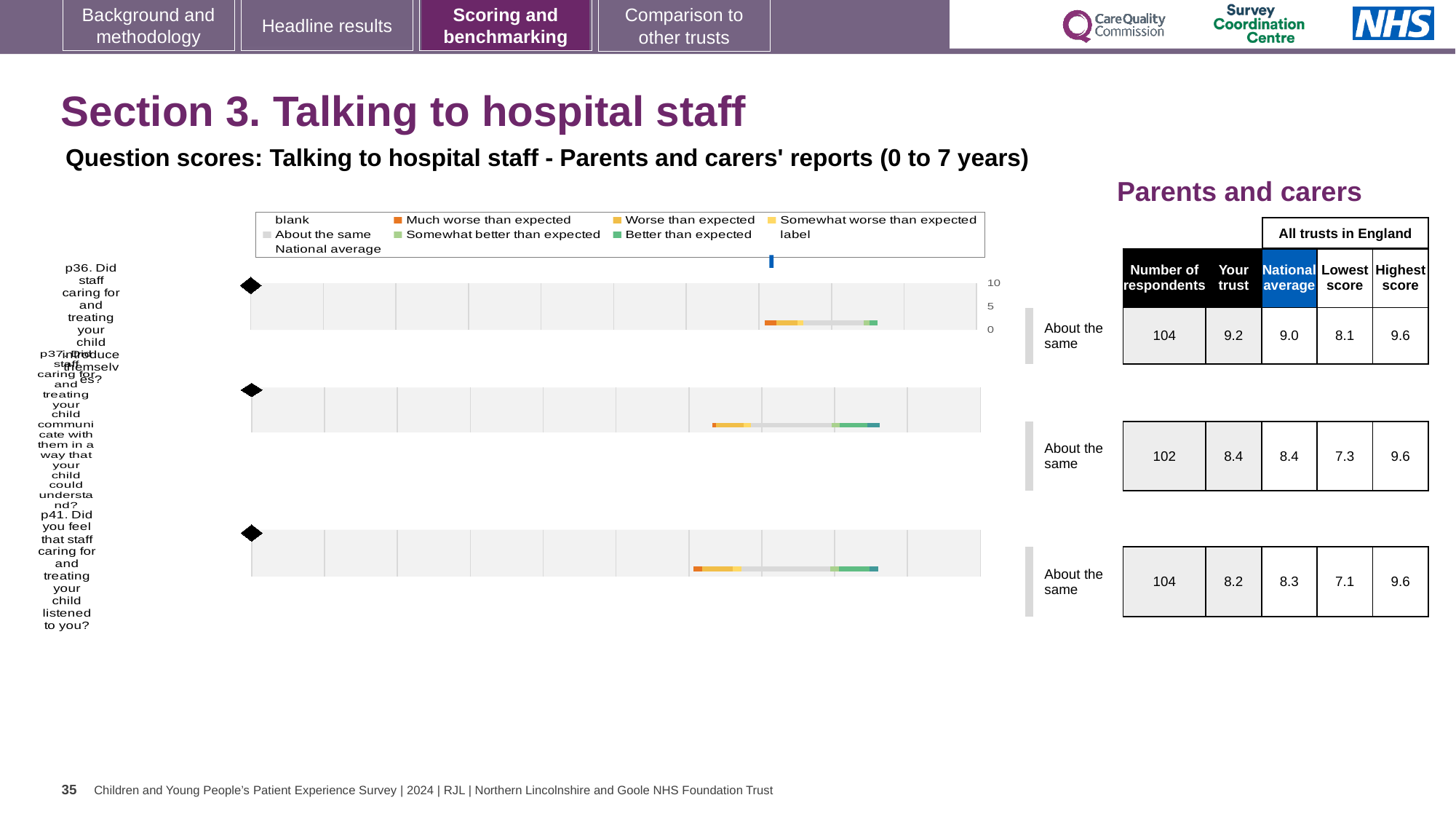
In the table beside the chart, which question has the highest 'Your trust' score? p36. Did staff caring for and treating your child introduce themselves? In the table beside the chart, what is the lowest score for p41 (staff listened to you)? 7.1 In the table beside the chart, how many respondents answered p37? 102 In the table beside the chart, what is the 'Your trust' score for p36 (Did staff introduce themselves)? 9.2 In the table beside the chart, what is the national average for p37 (communicate in a way your child could understand)? 8.4 In the table beside the chart, what is the difference between the 'Your trust' score and the national average for p36? 0.2 In the table beside the chart, which question has the lowest 'Your trust' score? p41. Did you feel that staff caring for and treating your child listened to you? How many questions (bars) are plotted in the chart? 3 What is the maximum value shown on the chart's axis? 10 What kind of chart is shown on the slide? bar chart What benchmark category is shown next to the chart for p36 (Did staff introduce themselves)? About the same How many entries does the chart legend list? 9